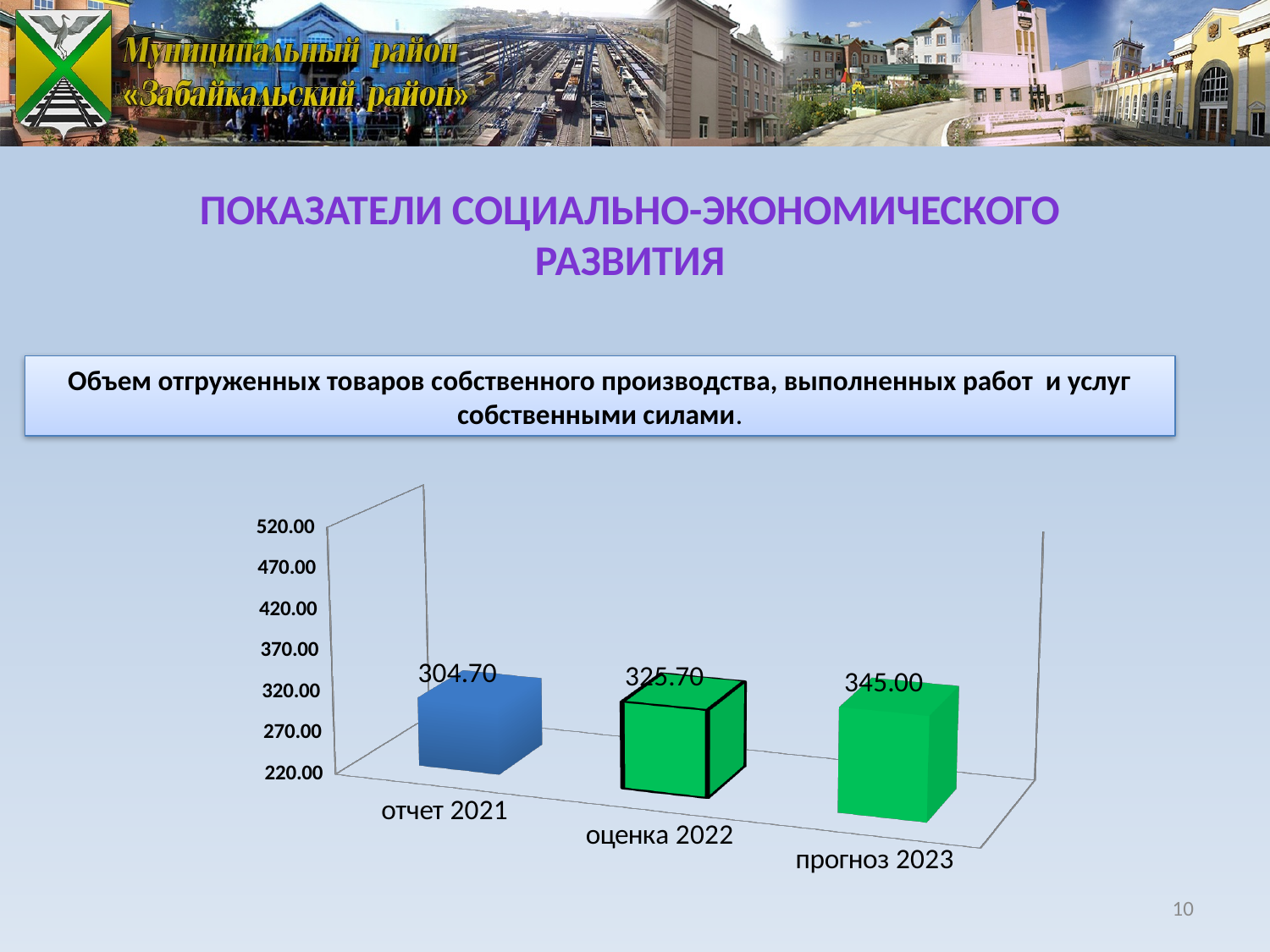
What kind of chart is shown on the slide? bar chart What is the value for отчет 2021? 304.70 Which category has the lowest value? отчет 2021 Do the values rise or fall from отчет 2021 to прогноз 2023? rise How many categories are shown on the x axis? 3 Which is larger, the value for оценка 2022 or the value for прогноз 2023? прогноз 2023 What is the value for прогноз 2023? 345.00 What is the difference between the values for прогноз 2023 and отчет 2021? 40.30 What is the value for оценка 2022? 325.70 What is the difference between the values for оценка 2022 and отчет 2021? 21.00 Which category has the highest value? прогноз 2023 Is the value for отчет 2021 greater or less than 320.00? less